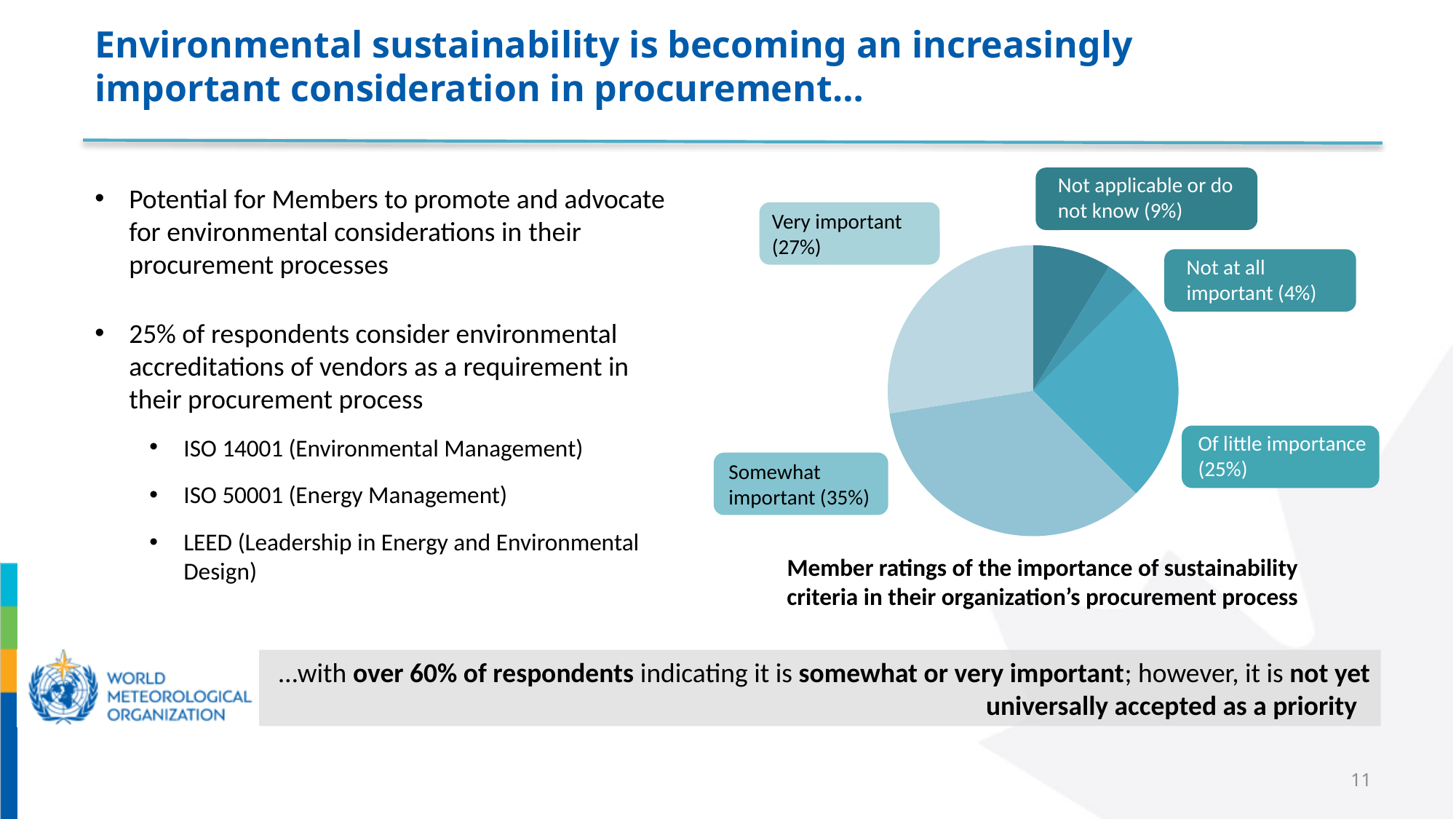
What share of respondents rated sustainability criteria as very important? 27% Which is larger: the share for 'Very important' or the share for 'Of little importance'? Very important What share of respondents rated sustainability criteria as of little importance? 25% Which rating category has the largest share of the pie? Somewhat important What share of respondents answered 'Not applicable or do not know'? 9% Which rating category has the smallest share of the pie? Not at all important What share of respondents rated sustainability criteria as not at all important? 4% How many categories are shown in the pie chart? 5 What is the difference in percentage points between 'Somewhat important' and 'Very important'? 8 What share of respondents rated sustainability criteria as somewhat important? 35% What is the caption of the chart? Member ratings of the importance of sustainability criteria in their organization's procurement process What type of chart is shown on the slide? Pie chart